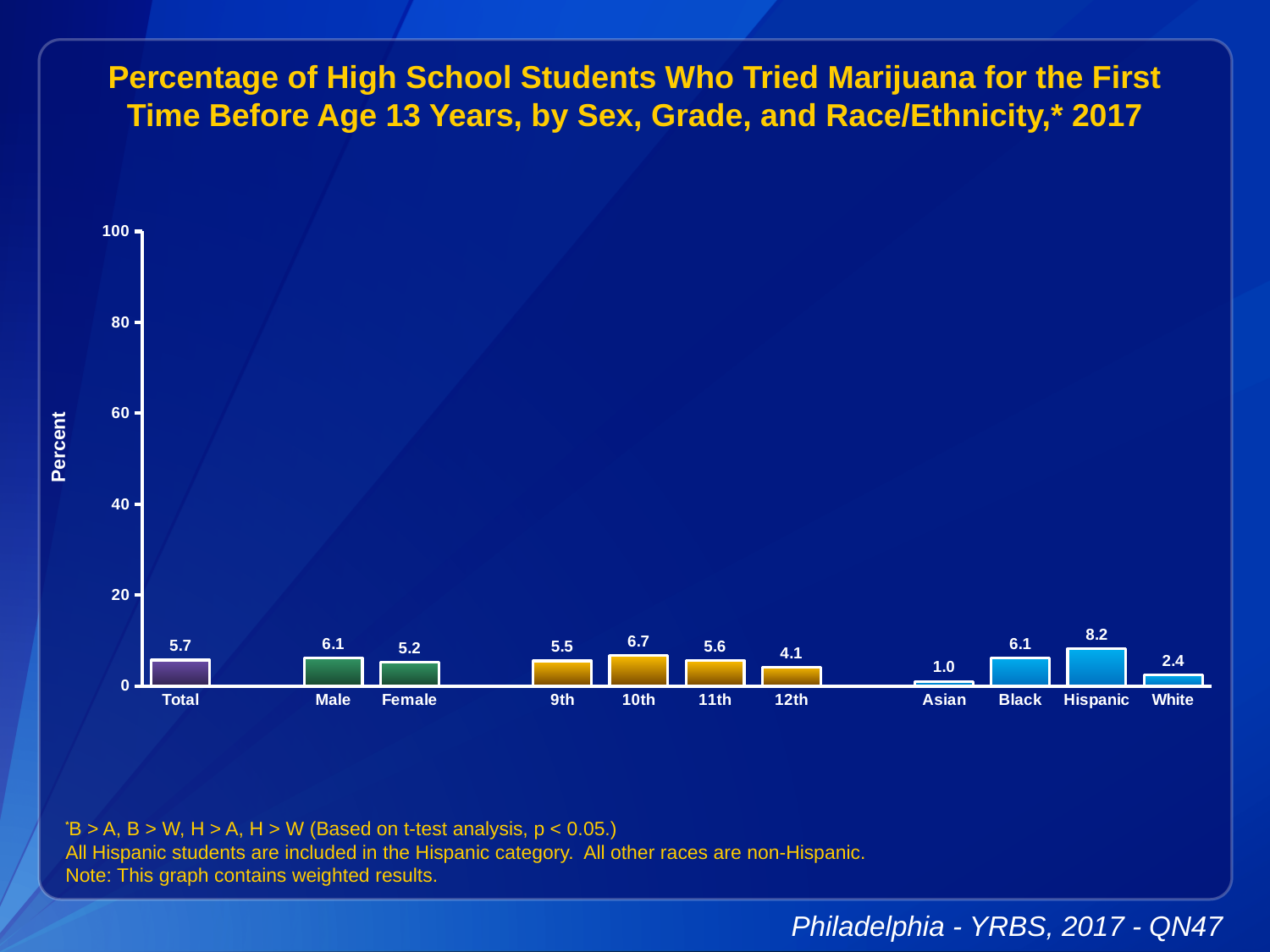
Which category has the highest value? Hispanic What is the value for 12th grade? 4.1 What is the label of the y axis? Percent What is the difference between the Hispanic and White values? 5.8 What kind of chart is this? bar chart What is the value for Hispanic students? 8.2 Is the value for Hispanic greater or less than 20? less What is the difference between the Male and Female values? 0.9 What is the value for Total? 5.7 Which category has the lowest value? Asian How many categories are shown on the x axis? 11 Which is larger, the value for 10th grade or 11th grade? 10th